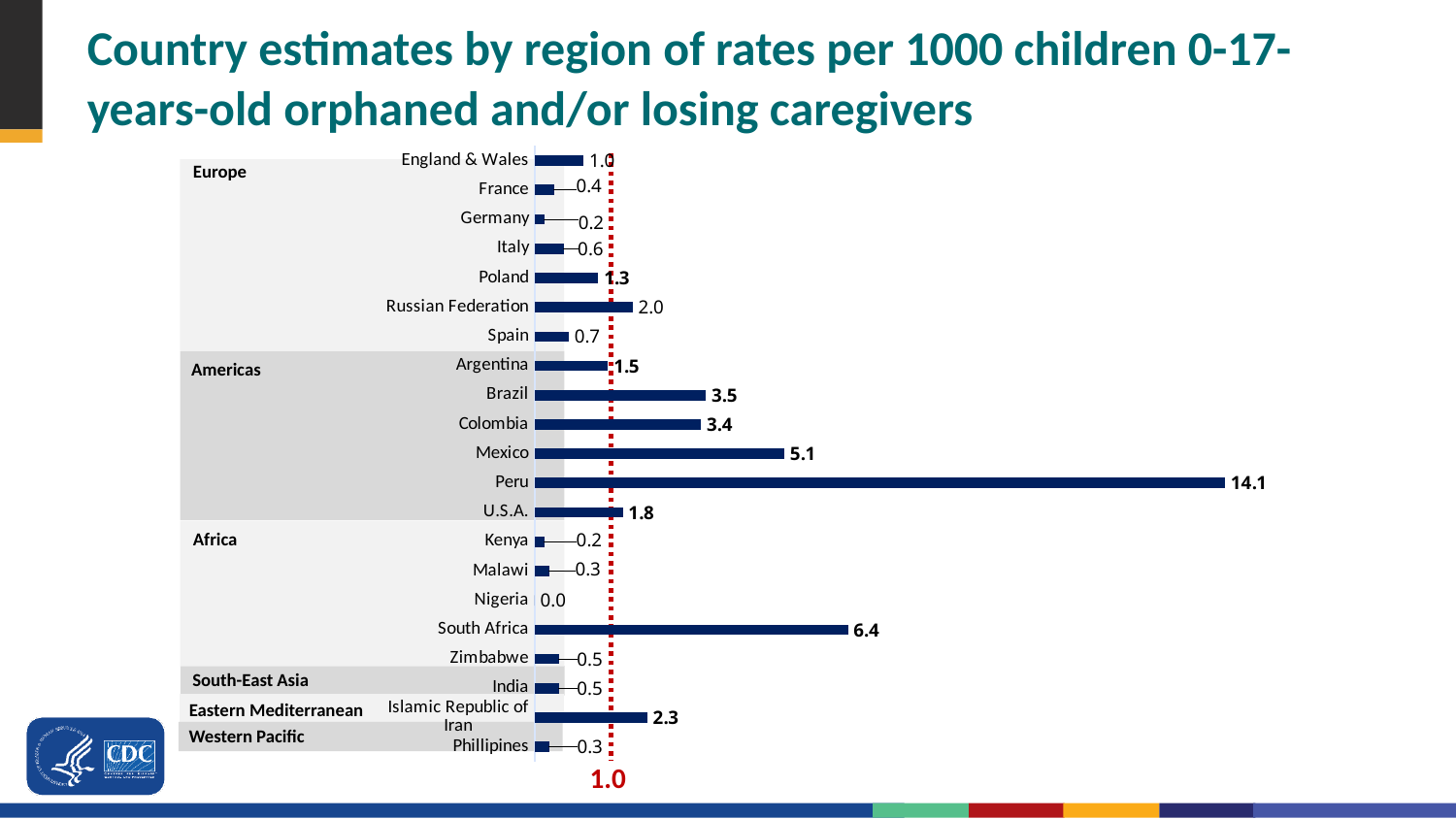
Which has a higher rate, the Russian Federation or the U.S.A.? Russian Federation What kind of chart is shown on the slide? Bar chart What is the difference between the rates for Brazil and Colombia? 0.1 What is the rate per 1000 children for the Islamic Republic of Iran? 2.3 What value does the red dashed vertical line mark? 1.0 What is the difference between the rates for Peru and South Africa? 7.7 Which country has the lowest rate on the chart? Nigeria What is the rate per 1000 children for Peru? 14.1 How many countries are shown on the chart? 21 Which country has the highest rate on the chart? Peru Which has a higher rate, Mexico or Brazil? Mexico What is the rate per 1000 children for South Africa? 6.4